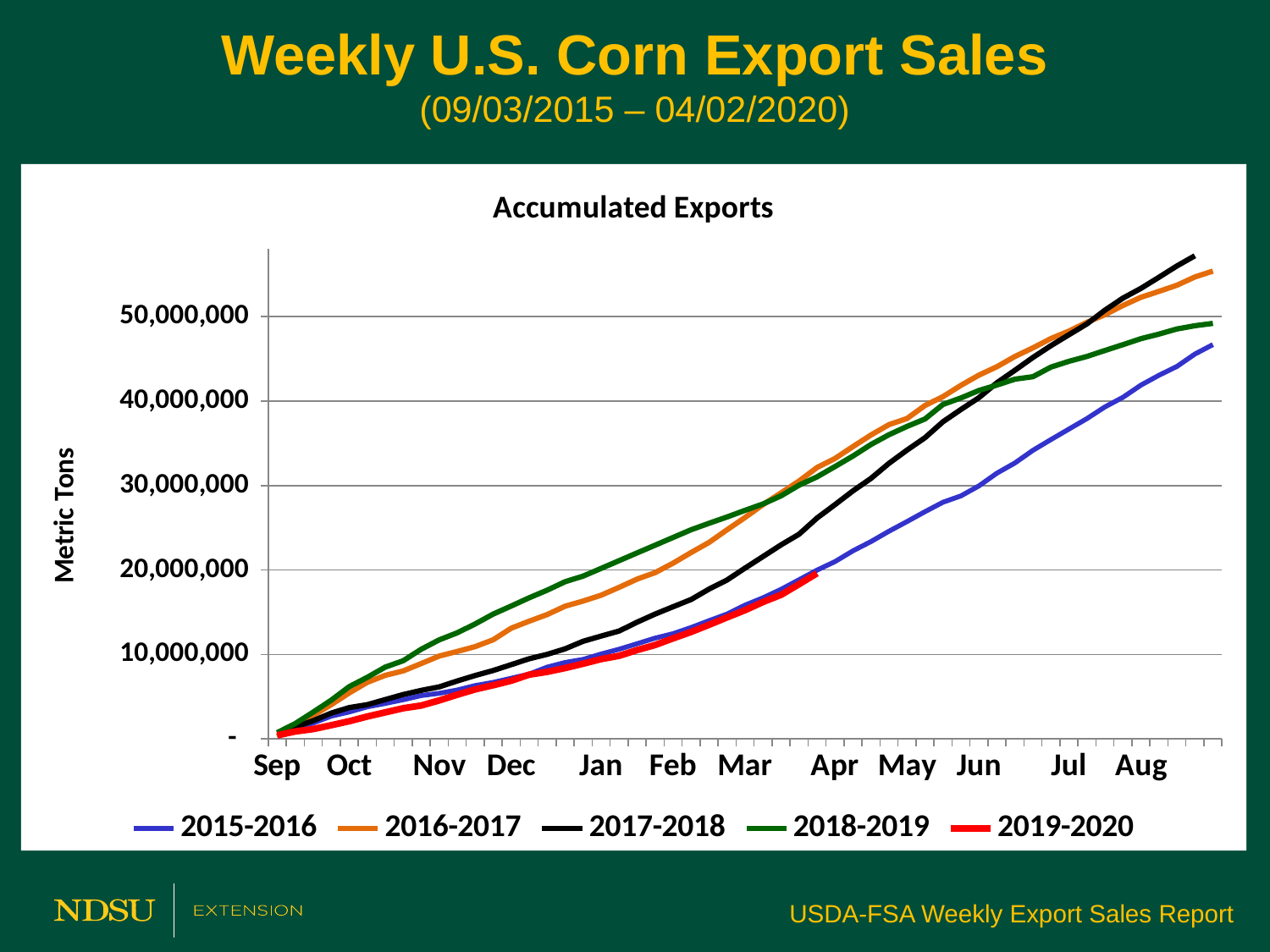
Is the final value for 2017-2018 in Aug greater or less than 50,000,000? greater Is the final value for 2015-2016 in Aug greater or less than 50,000,000? less What is the title of the chart? Accumulated Exports Which series stops in March rather than continuing through Aug? 2019-2020 Among the series that run through Aug, which ends at the lowest value? 2015-2016 In Jan, which is larger: the value for 2018-2019 or the value for 2015-2016? 2018-2019 How many series does the legend list? 5 Which series reaches the highest value at the end of the season in Aug? 2017-2018 Do the accumulated export values rise or fall from Sep to Aug for each series? rise What kind of chart is shown on the slide? line chart Which series is highest in Dec? 2018-2019 What is the label on the vertical axis? Metric Tons